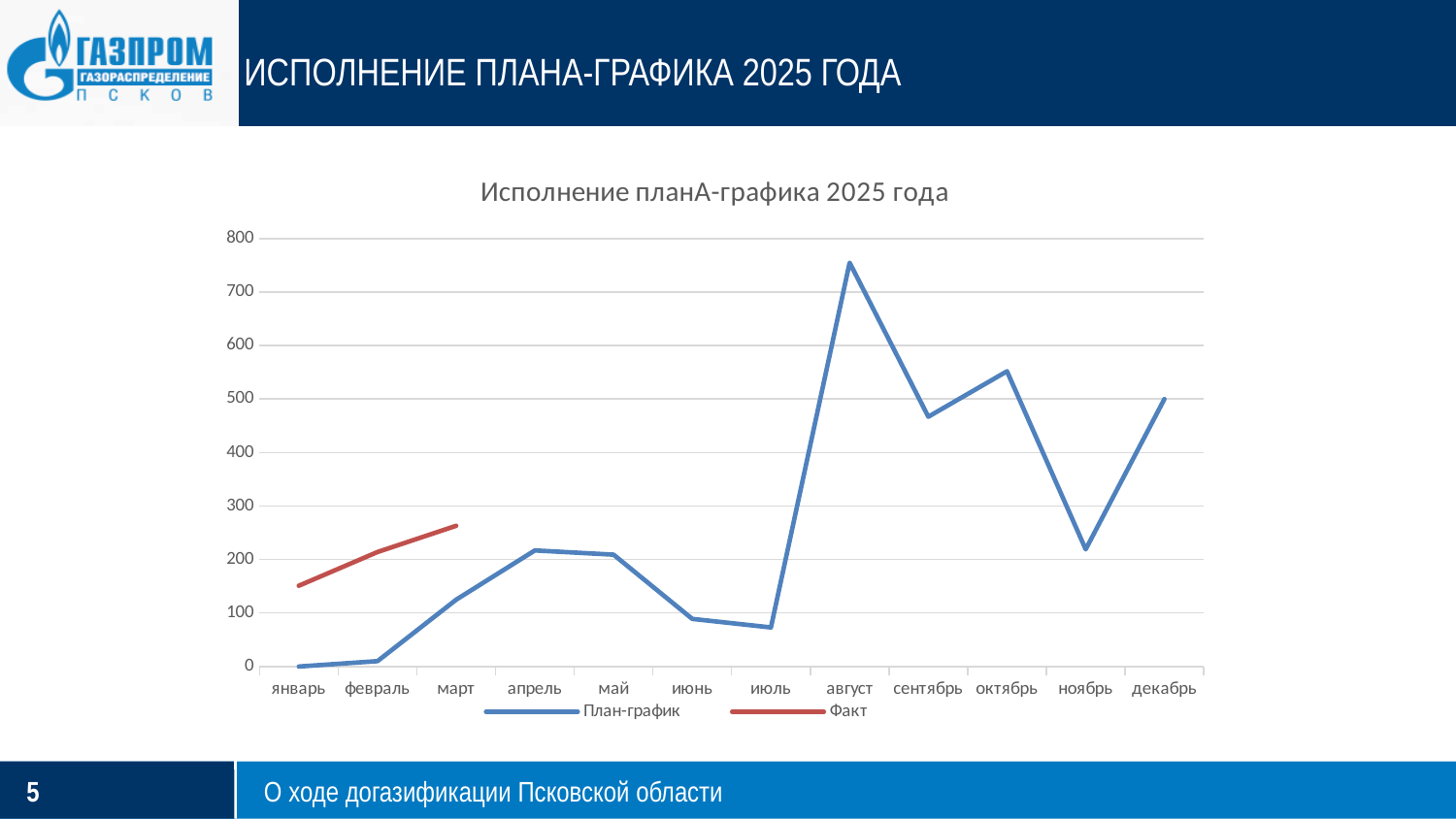
How many months are shown on the x axis? 12 Is the value of План-график for июль greater or less than 100? less How many series does the legend list? 2 In which month does the План-график series reach its highest value? август In which month is the План-график series at its lowest value? январь Is the value of План-график for ноябрь greater or less than 300? less Which series is drawn in red? Факт Is the value of Факт for март greater or less than 200? greater What kind of chart is shown on the slide? line chart Does the Факт series rise or fall from январь to март? rise Which is larger in март: the План-график value or the Факт value? Факт